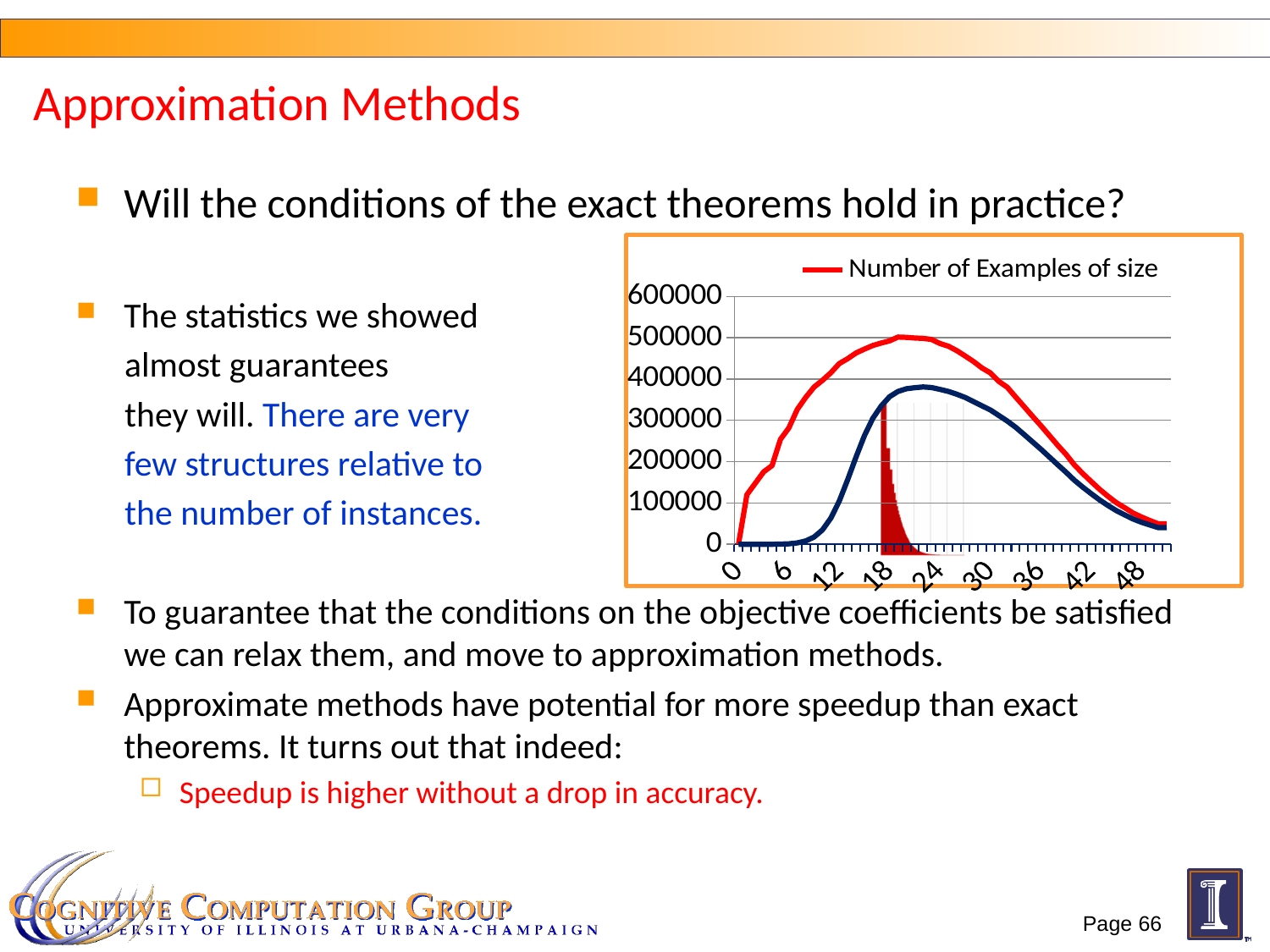
What is the highest value labelled on the chart's vertical axis? 600000 Is the value of the dark blue line at x = 24 greater or less than 400000? less What kind of chart is shown on the slide? line chart Is the value of the dark blue line at x = 6 greater or less than 100000? less Does the red 'Number of Examples of size' line rise or fall between x = 30 and x = 48? fall Is the value of the red 'Number of Examples of size' line at x = 48 greater or less than 100000? less What series name does the chart's legend show? Number of Examples of size At x = 12, which line has the larger value, the red line or the dark blue line? the red line Does the red 'Number of Examples of size' line rise or fall between x = 0 and x = 12? rise